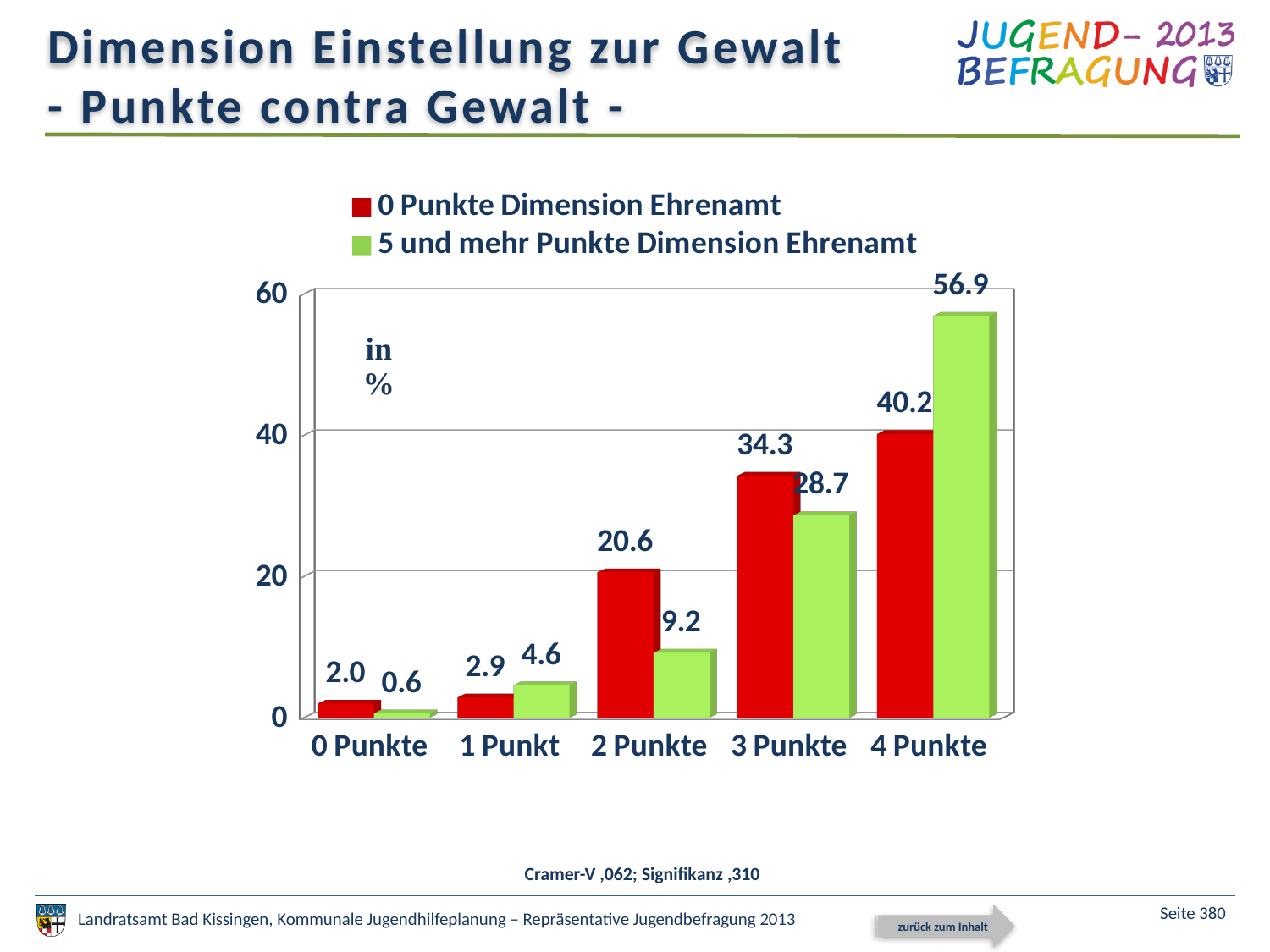
What is the difference between the two series for 4 Punkte? 16.7 Which category has the lowest value in the series 5 und mehr Punkte Dimension Ehrenamt? 0 Punkte What kind of chart is shown on the slide? bar chart Do the values in the series 5 und mehr Punkte Dimension Ehrenamt rise or fall from 0 Punkte to 4 Punkte? rise For 3 Punkte, which series has the larger value? 0 Punkte Dimension Ehrenamt What is the value for 2 Punkte in the series 0 Punkte Dimension Ehrenamt? 20.6 What is the value for 4 Punkte in the series 5 und mehr Punkte Dimension Ehrenamt? 56.9 How many categories are shown on the x axis? 5 Which category has the highest value in the series 0 Punkte Dimension Ehrenamt? 4 Punkte Is the value for 4 Punkte in the series 0 Punkte Dimension Ehrenamt greater or less than 40? greater What is the value for 1 Punkt in the series 5 und mehr Punkte Dimension Ehrenamt? 4.6 How many series does the legend list? 2